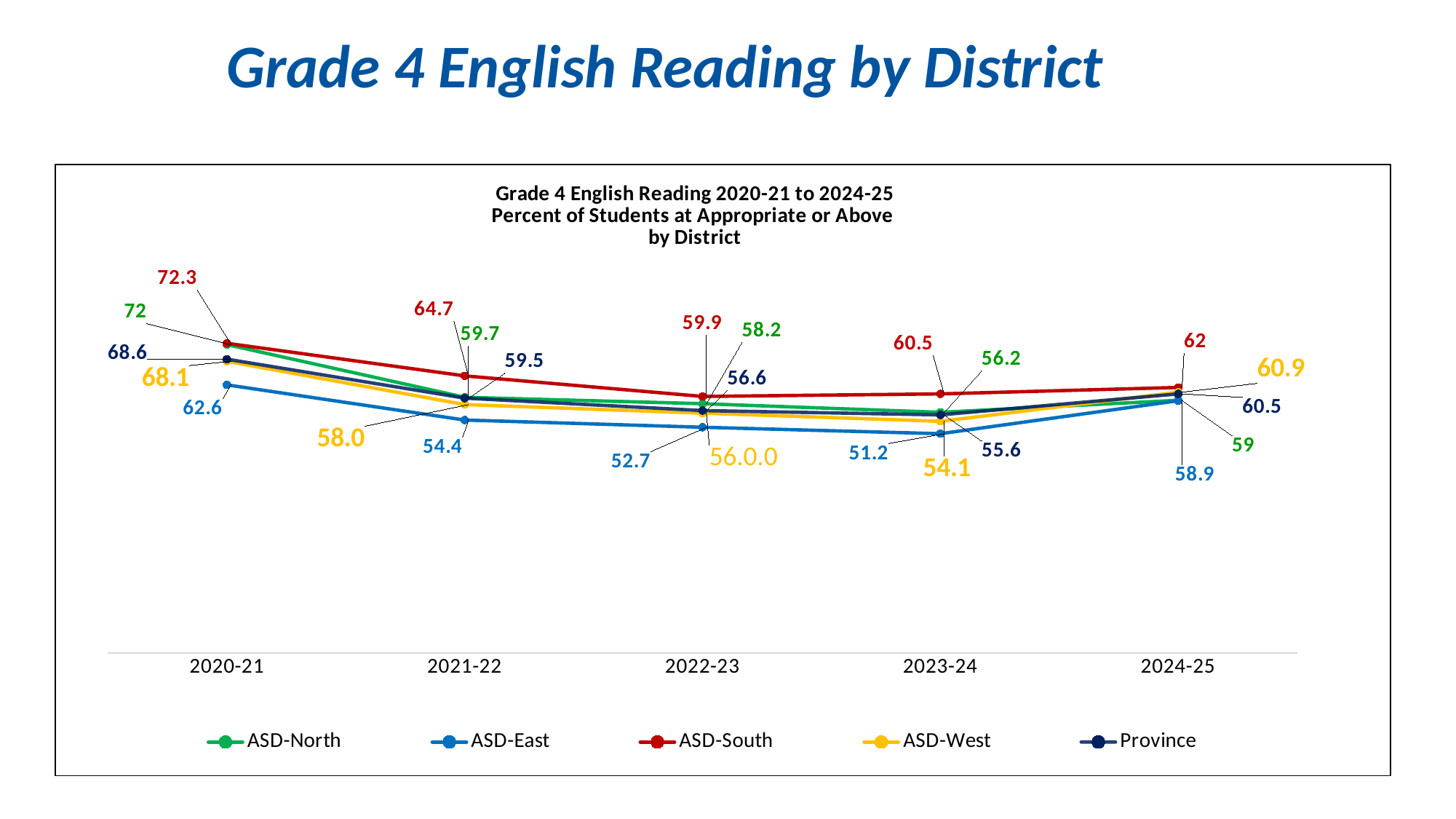
What was the ASD-South value in 2020-21? 72.3 What was the ASD-West value in 2024-25? 60.9 Which district had the lowest value in 2020-21? ASD-East What was the Province value in 2022-23? 56.6 Did the ASD-East value rise or fall from 2020-21 to 2023-24? fall What is the difference between the ASD-South and ASD-East values in 2022-23? 7.2 What was the ASD-East value in 2023-24? 51.2 Which district had the highest value in 2021-22? ASD-South How many school years are plotted along the x axis? 5 What type of chart is shown on the slide? line chart How many series does the legend list? 5 In 2023-24, which was larger: ASD-North or ASD-West? ASD-North